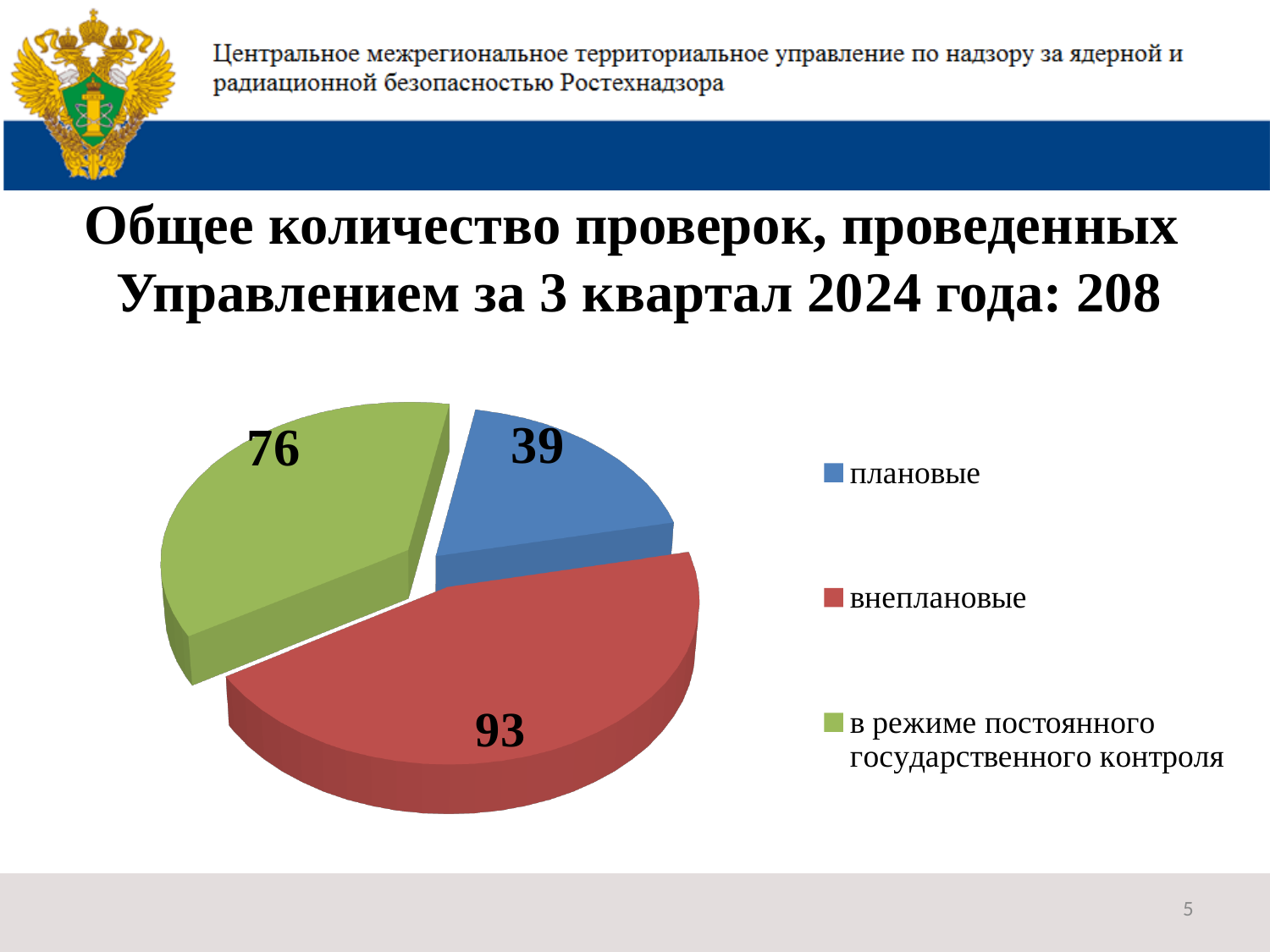
How many slices does the pie chart have? 3 What is the value for внеплановые? 93 Which category has the smallest slice? плановые What is the value for плановые? 39 Which category has the largest slice? внеплановые What is the difference between внеплановые and плановые? 54 What is the value for в режиме постоянного государственного контроля? 76 How many entries does the legend list? 3 What kind of chart is shown on the slide? pie chart What is the total of all slices in the pie chart? 208 Which is larger, в режиме постоянного государственного контроля or плановые? в режиме постоянного государственного контроля What colour is the slice for внеплановые? red